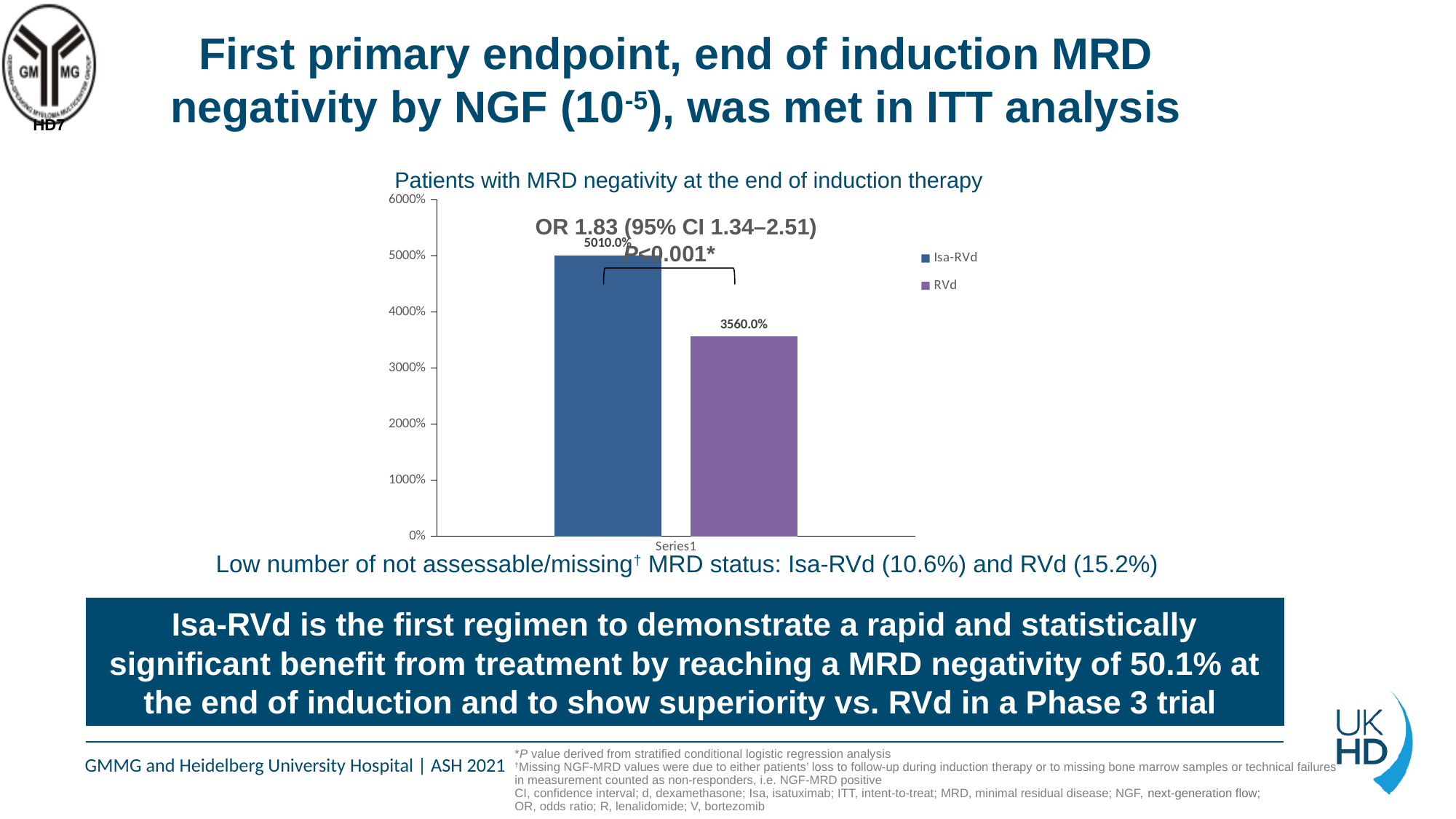
What is the value shown for RVd in the chart? 3560.0% Is the value for Isa-RVd greater or less than 4000%? greater What kind of chart is shown on the slide? Bar chart How many series does the legend list? 2 What is the value shown for Isa-RVd in the chart? 5010.0% What colour is the Isa-RVd bar in the chart? Blue What is the title of the chart? Patients with MRD negativity at the end of induction therapy Which series has the highest value in the chart? Isa-RVd What is the difference between the Isa-RVd and RVd values shown on the chart? 1450.0% Is the value for RVd greater or less than 4000%? less Which series has the lowest value in the chart? RVd Which series has the higher bar, Isa-RVd or RVd? Isa-RVd